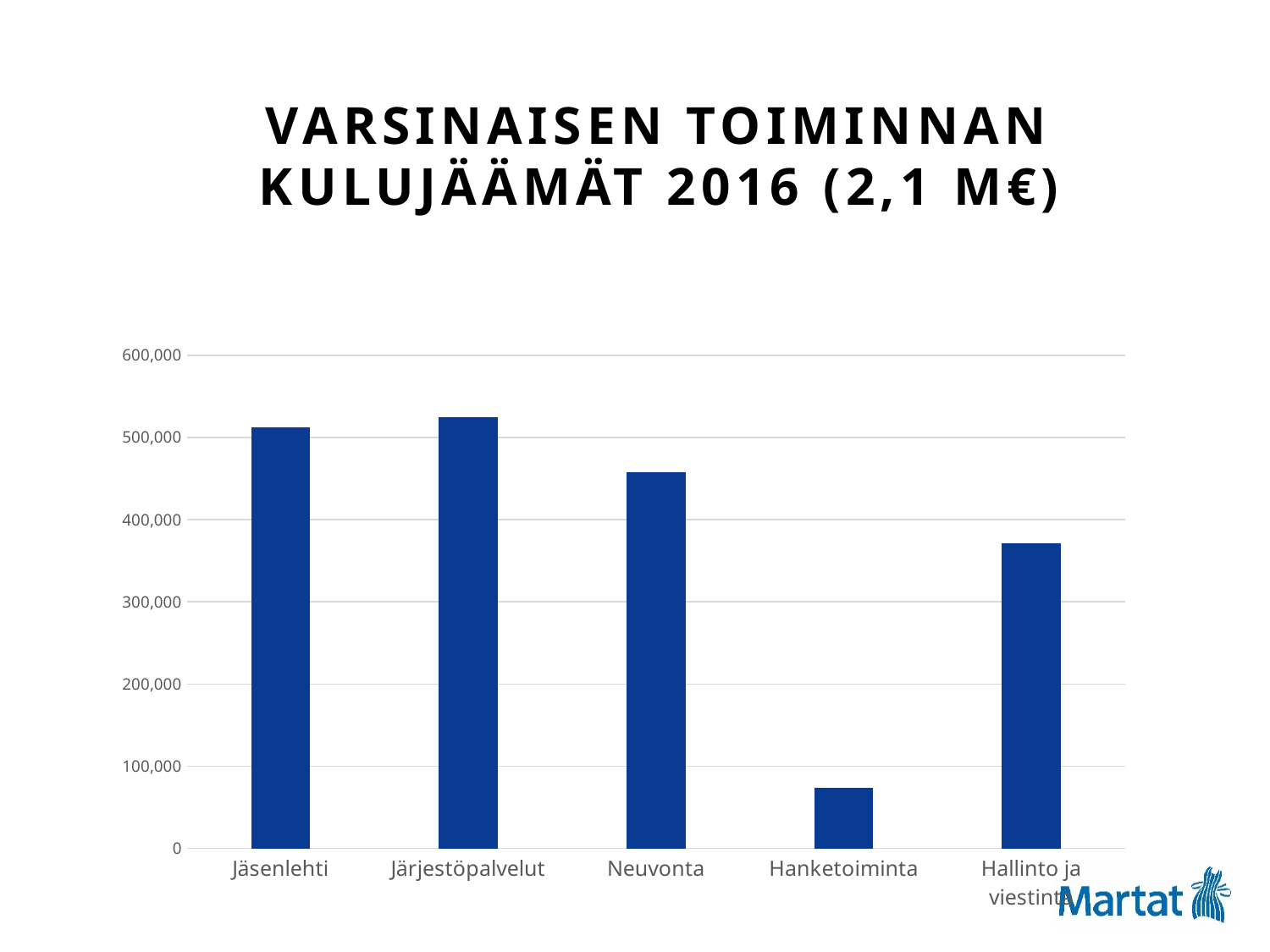
Is the value for Neuvonta greater or less than 500,000? less Is the value for Hallinto ja viestintä greater or less than 400,000? less What kind of chart is shown on the slide? bar chart Is the value for Neuvonta greater or less than 400,000? greater How many categories are shown on the x axis of the chart? 5 Which has the larger value, Neuvonta or Hallinto ja viestintä? Neuvonta What is the title of the chart on the slide? VARSINAISEN TOIMINNAN KULUJÄÄMÄT 2016 (2,1 M€) Which category has the lowest value in the chart? Hanketoiminta Which has the larger value, Hanketoiminta or Hallinto ja viestintä? Hallinto ja viestintä